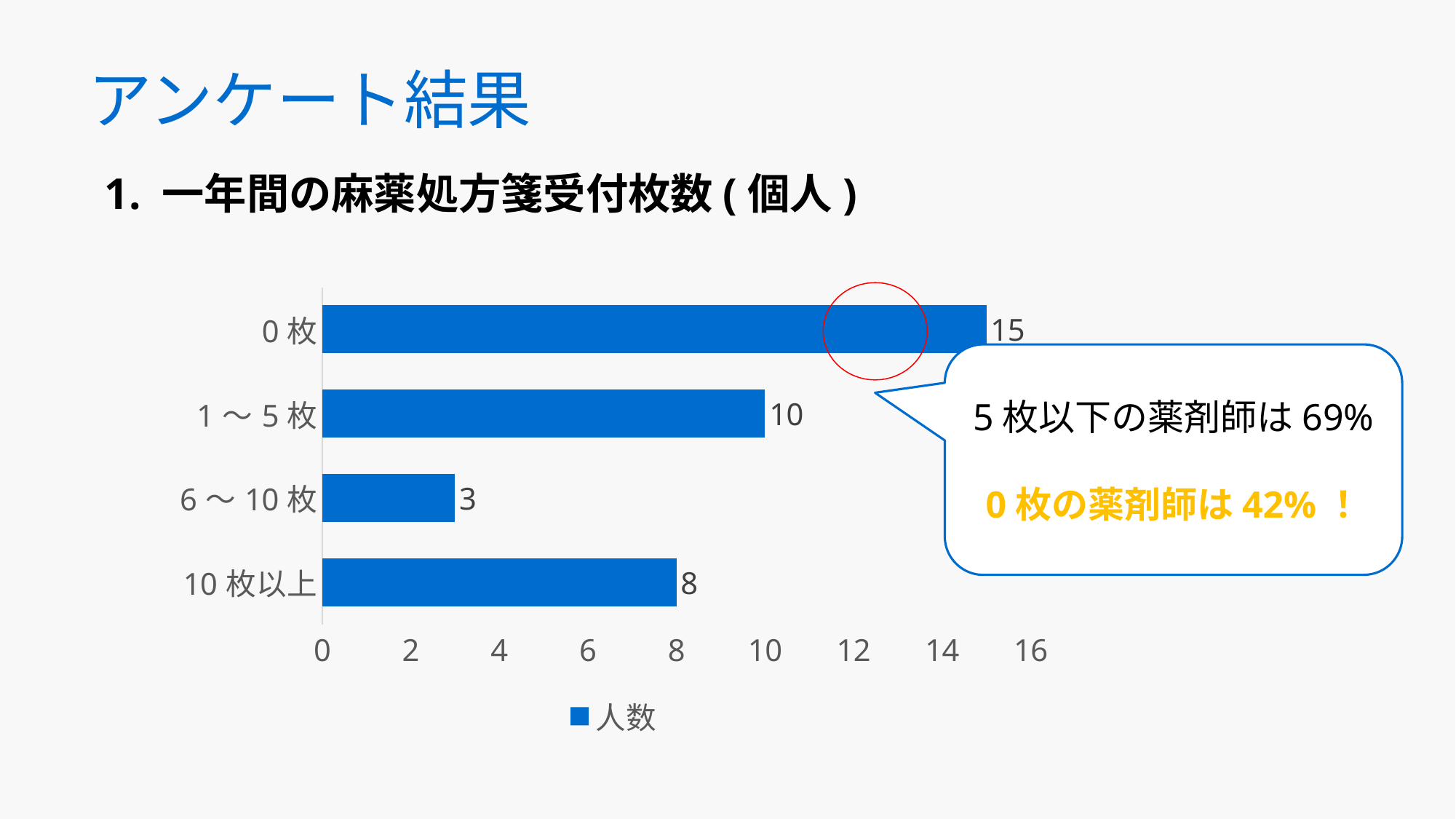
Which category has the lowest value? 6～10枚 What is the value for 1～5枚? 10 Which category has the highest value? 0枚 What is the value for 0枚? 15 How many categories are shown in the chart? 4 What is the value for 6～10枚? 3 What is the difference between the values for 0枚 and 1～5枚? 5 How many series does the legend list? 1 What is the legend entry for the series in the chart? 人数 What kind of chart is shown on the slide? Bar chart Which is larger, the value for 10枚以上 or the value for 6～10枚? 10枚以上 What is the value for 10枚以上? 8